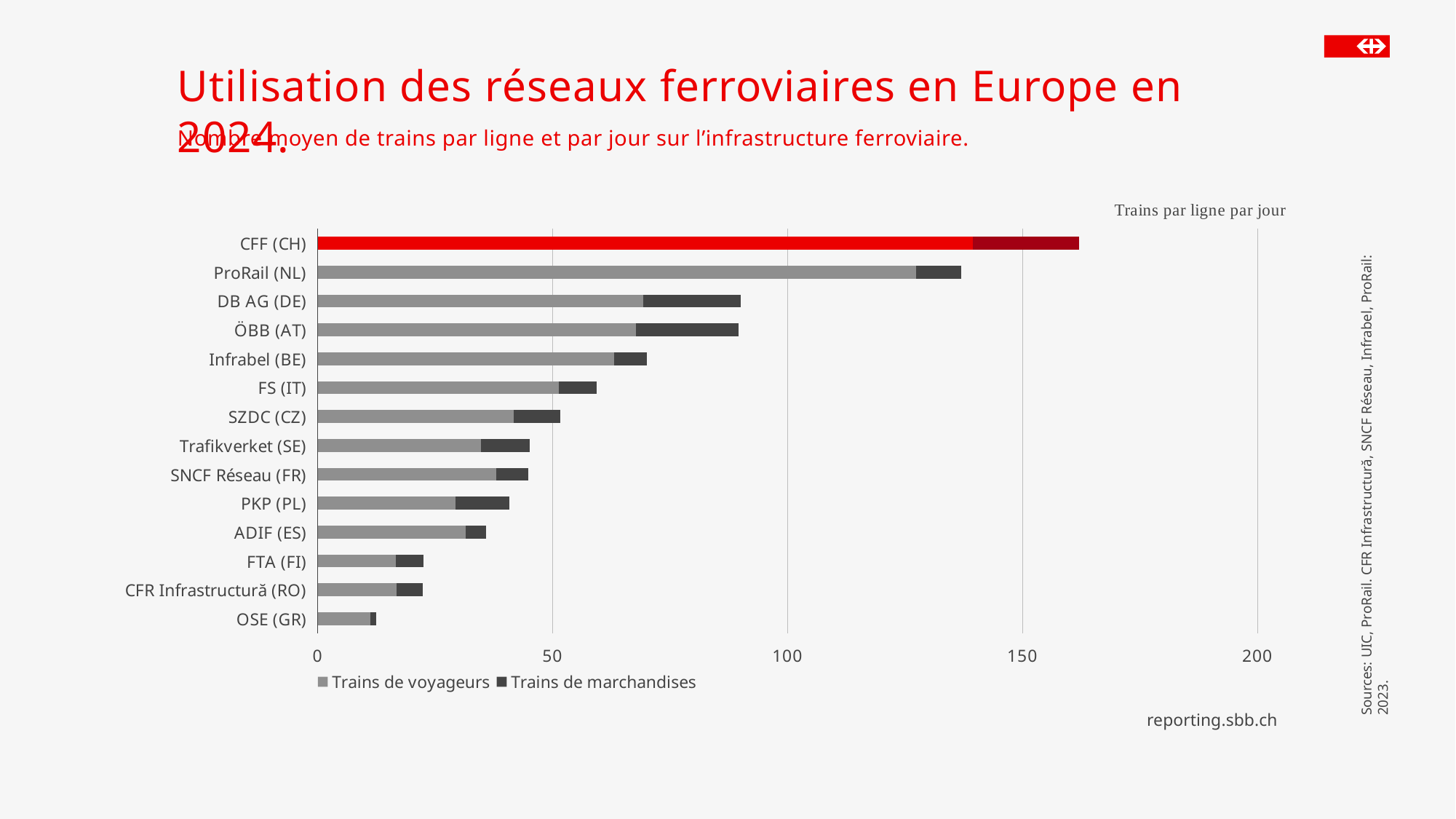
Is the total value for ProRail (NL) greater or less than 150? less Which network has the highest total number of trains per line per day? CFF (CH) How many series does the legend list? 2 What kind of chart is shown on the slide? bar chart Is the total value for DB AG (DE) greater or less than 100? less Is the total value for Infrabel (BE) greater or less than 50? greater Which network has the lowest total number of trains per line per day? OSE (GR) Which has a larger total, Infrabel (BE) or FS (IT)? Infrabel (BE) How many railway networks (categories) are plotted in the chart? 14 What are the two series named in the legend? Trains de voyageurs, Trains de marchandises